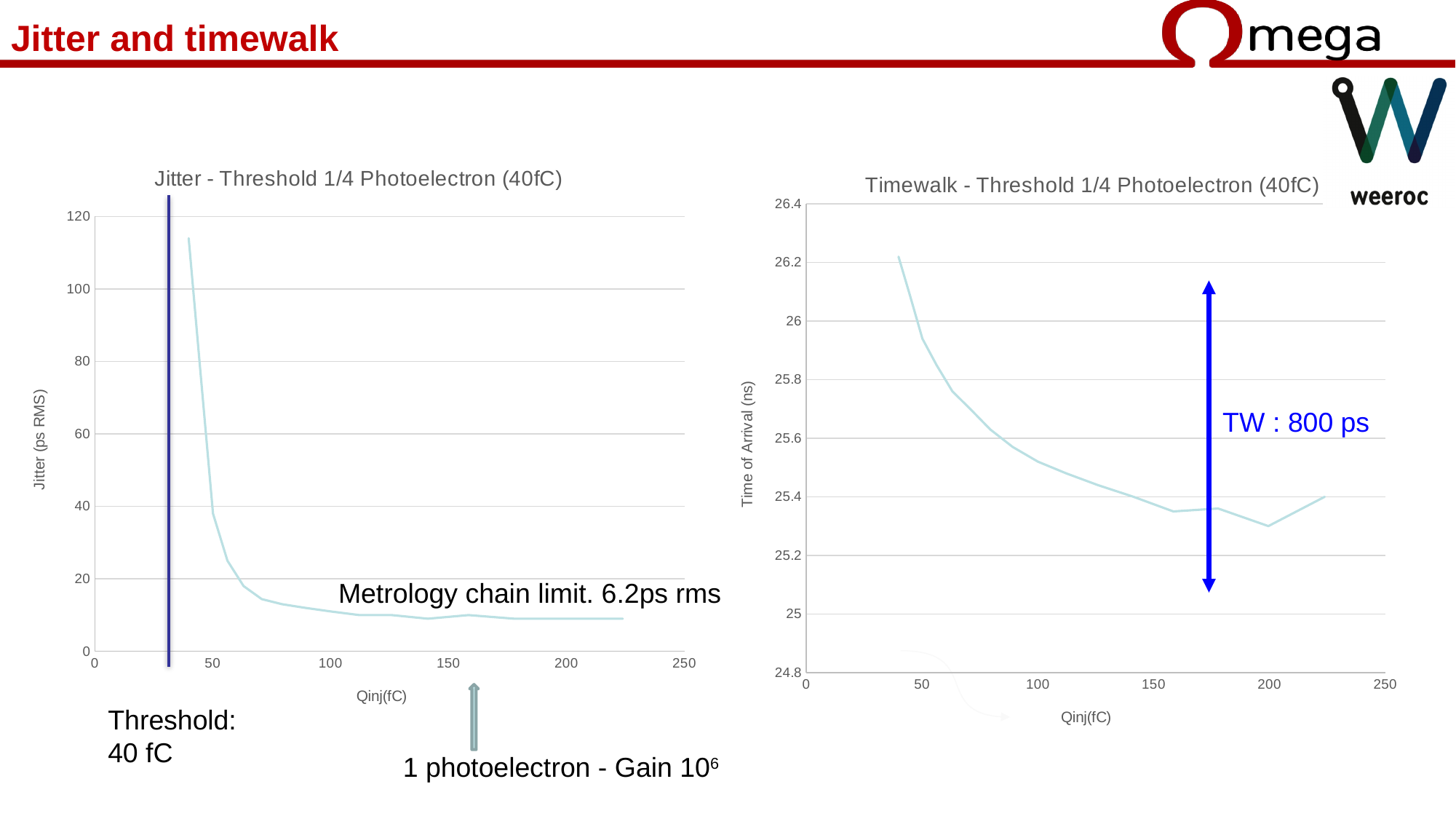
In the Jitter chart, is the jitter at Qinj = 100 fC greater or less than 20 ps RMS? less In the Timewalk chart, is the time of arrival at Qinj = 100 fC greater or less than 25.8 ns? less What kind of chart is the Timewalk - Threshold 1/4 Photoelectron (40fC) chart? line chart What kind of chart is the Jitter - Threshold 1/4 Photoelectron (40fC) chart? line chart What is the y-axis label of the Timewalk chart? Time of Arrival (ns) In the Jitter chart, does the jitter rise or fall as Qinj increases from 40 fC to 225 fC? fall In the Timewalk chart, does the time of arrival generally rise or fall as Qinj increases from 40 fC to 150 fC? fall What timewalk value is annotated next to the blue arrow on the Timewalk chart? TW : 800 ps In the Jitter chart, is the jitter at Qinj = 40 fC larger or smaller than the jitter at Qinj = 200 fC? larger In the Timewalk chart, is the time of arrival at Qinj = 200 fC greater or less than 25.4 ns? less